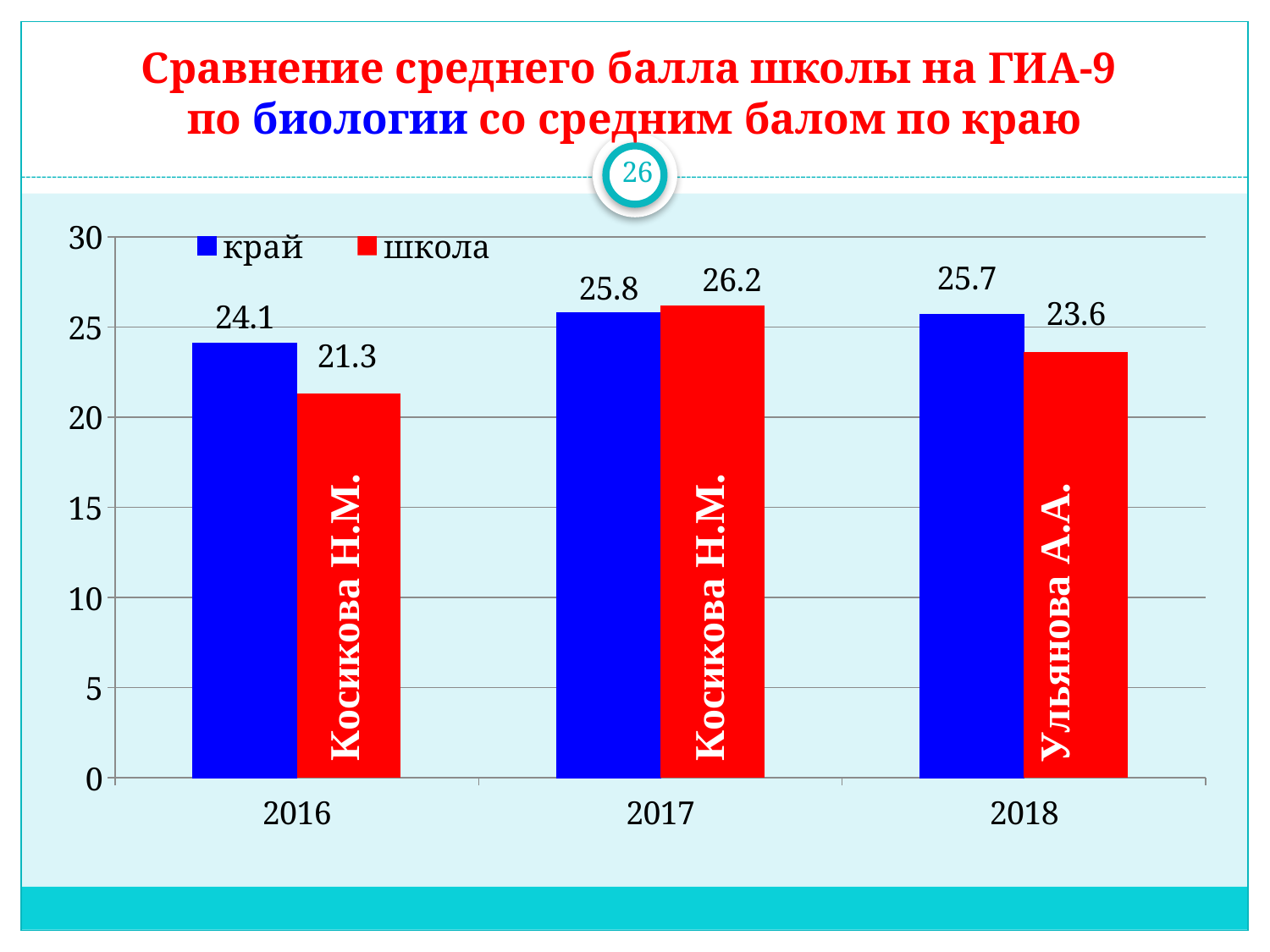
Which is larger in 2018, край or школа? край Which teacher's name is written on the школа bar for 2018? Ульянова А.А. What is the value for школа in 2018? 23.6 What is the value for край in 2016? 24.1 In which year is the школа value highest? 2017 What is the difference between край and школа in 2016? 2.8 How many years are shown on the x axis? 3 Which is larger in 2017, край or школа? школа How many series does the legend list? 2 What kind of chart is shown? bar chart In which year is the школа value lowest? 2016 What is the value for школа in 2017? 26.2